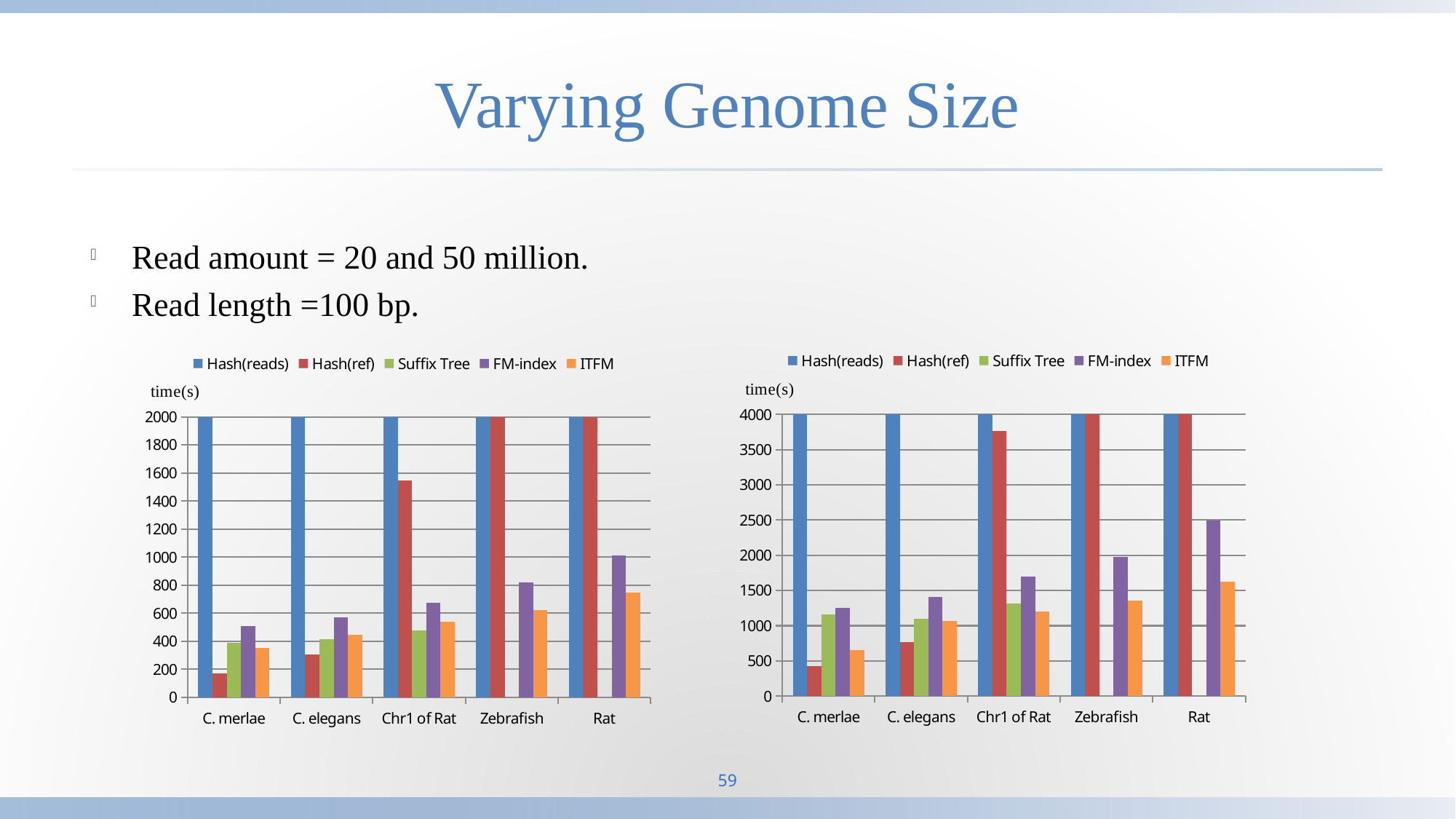
In the right chart, do the FM-index values rise or fall from C. merlae to Rat? rise What kind of chart is the left chart on the slide? bar chart In the left chart, which is larger for C. merlae: FM-index or ITFM? FM-index How many categories are shown on the x axis of the left chart? 5 In the right chart, is the FM-index value for Rat greater or less than 2000? greater In the right chart, is the ITFM value for C. merlae greater or less than 1000? less In the right chart, is the Hash(ref) value for Chr1 of Rat greater or less than 3500? greater What is the label on the y axis of the right chart? time(s) How many series does the legend of the right chart list? 5 In the left chart, which series has the lowest value for C. merlae? Hash(ref)